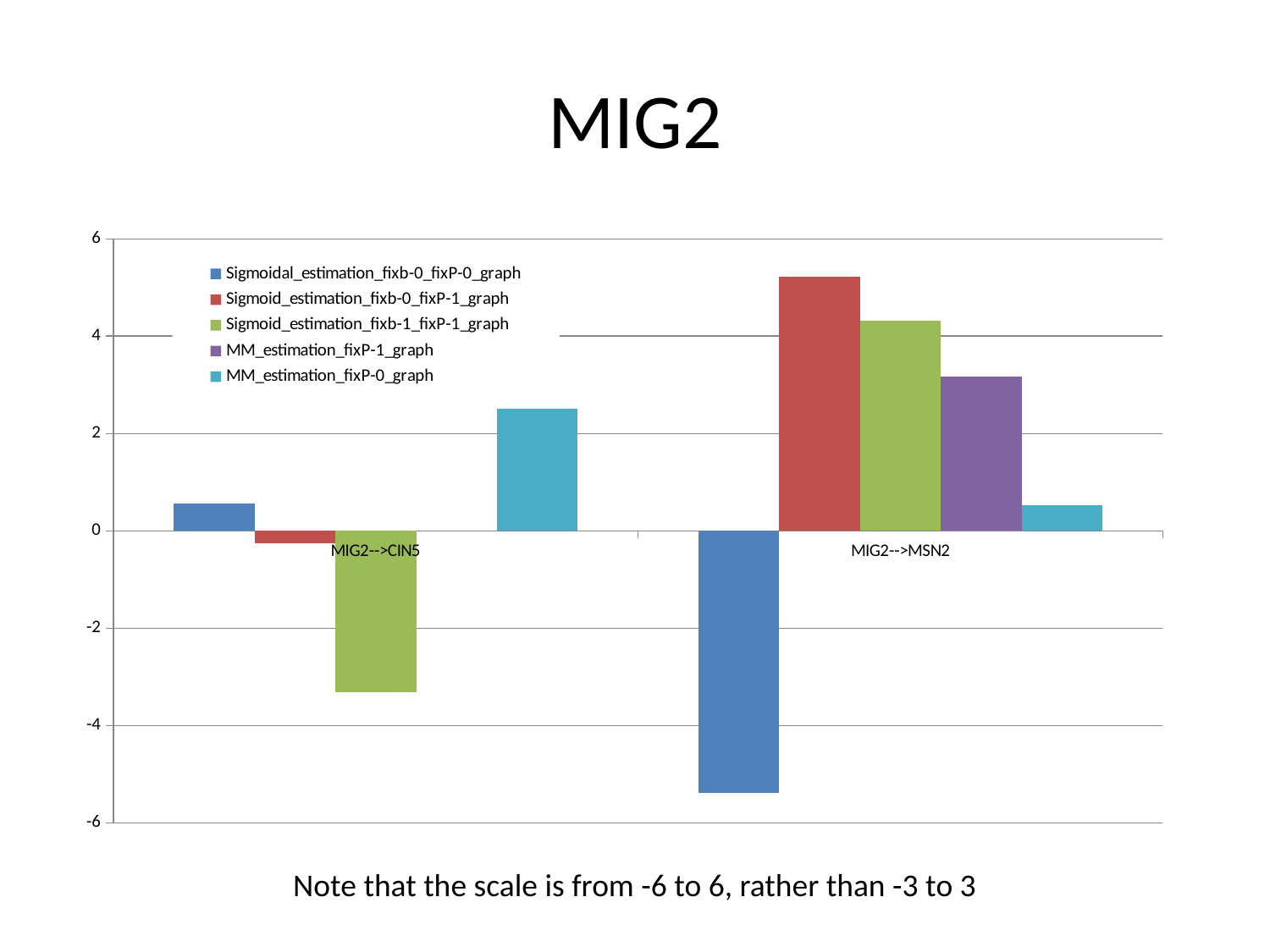
Is the value for Sigmoidal_estimation_fixb-0_fixP-0_graph at MIG2-->MSN2 greater or less than -4? less Is the value for Sigmoid_estimation_fixb-0_fixP-1_graph at MIG2-->MSN2 greater or less than 4? greater What is the title of the slide? MIG2 How many series does the legend list? 5 Which series has the highest value at MIG2-->MSN2? Sigmoid_estimation_fixb-0_fixP-1_graph Which series has the lowest value at MIG2-->CIN5? Sigmoid_estimation_fixb-1_fixP-1_graph Is the value for MM_estimation_fixP-0_graph at MIG2-->CIN5 greater or less than 2? greater What kind of chart is shown on the slide? bar chart Which series is shown in red in the legend? Sigmoid_estimation_fixb-0_fixP-1_graph At MIG2-->MSN2, which is larger: the value for Sigmoid_estimation_fixb-1_fixP-1_graph or the value for MM_estimation_fixP-1_graph? Sigmoid_estimation_fixb-1_fixP-1_graph How many categories are shown on the x axis? 2